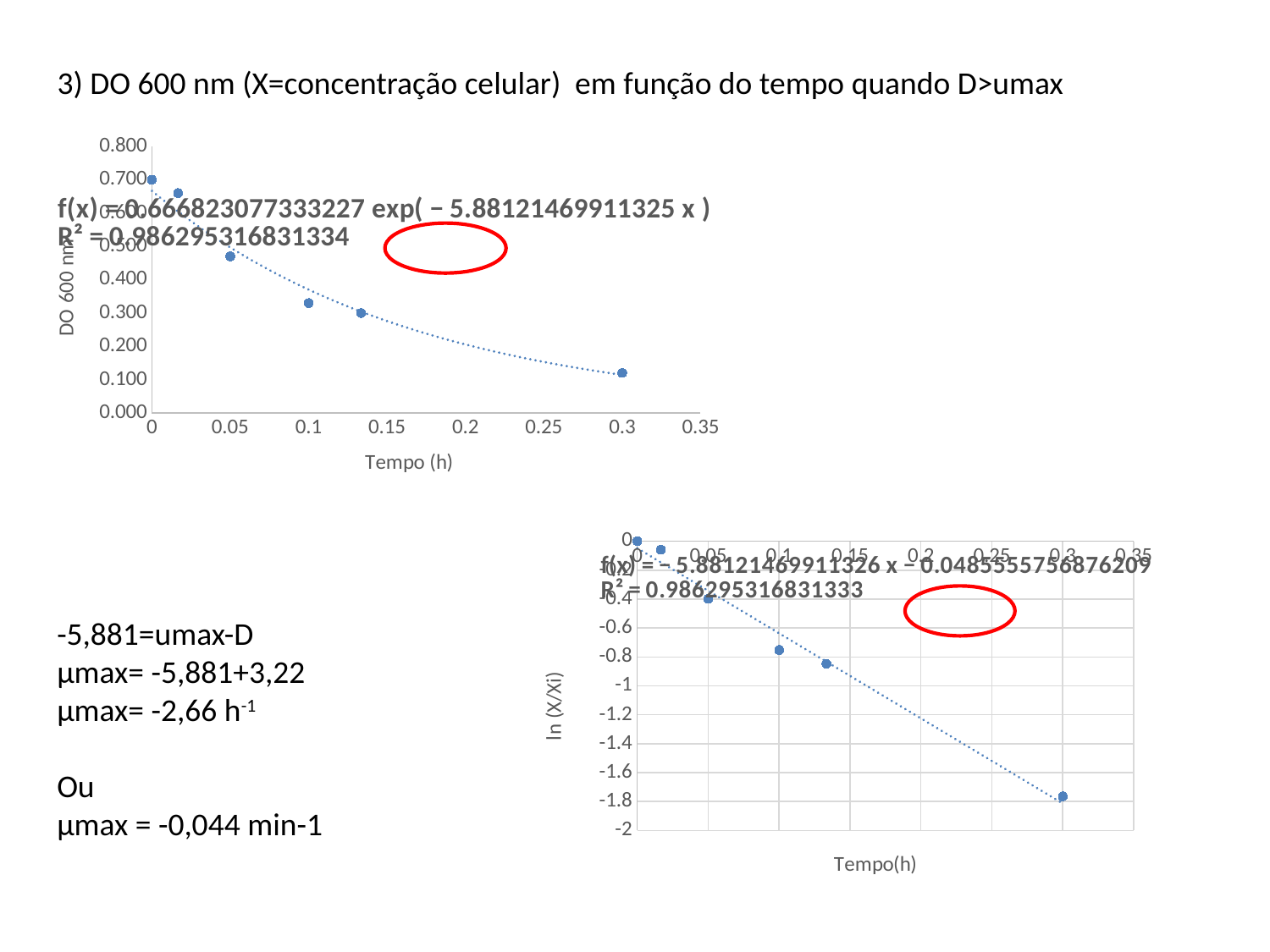
What R² value is displayed on the top chart (DO 600 nm)? 0.986295316831334 In the bottom chart (ln (X/Xi) vs Tempo), how many data points are plotted? 6 In the top chart (DO 600 nm), is the value at Tempo 0.05 h greater or less than 0.400? greater In the top chart (DO 600 nm), do the values rise or fall as Tempo (h) increases? fall In the top chart (DO 600 nm), is the value at Tempo 0.3 h greater or less than 0.200? less In the top chart (DO 600 nm), how many data points are plotted? 6 What is the y-axis title of the bottom chart? ln (X/Xi) In the top chart (DO 600 nm), which has the larger value: the point at Tempo 0.1 h or the point at Tempo 0.3 h? 0.1 h In the bottom chart (ln (X/Xi)), do the values rise or fall as Tempo(h) increases? fall In the bottom chart (ln (X/Xi)), is the value at Tempo 0.3 h greater or less than -1.6? less In the top chart (DO 600 nm), at which Tempo value is the highest point plotted? 0 What kind of chart is the top chart (DO 600 nm vs Tempo)? scatter chart